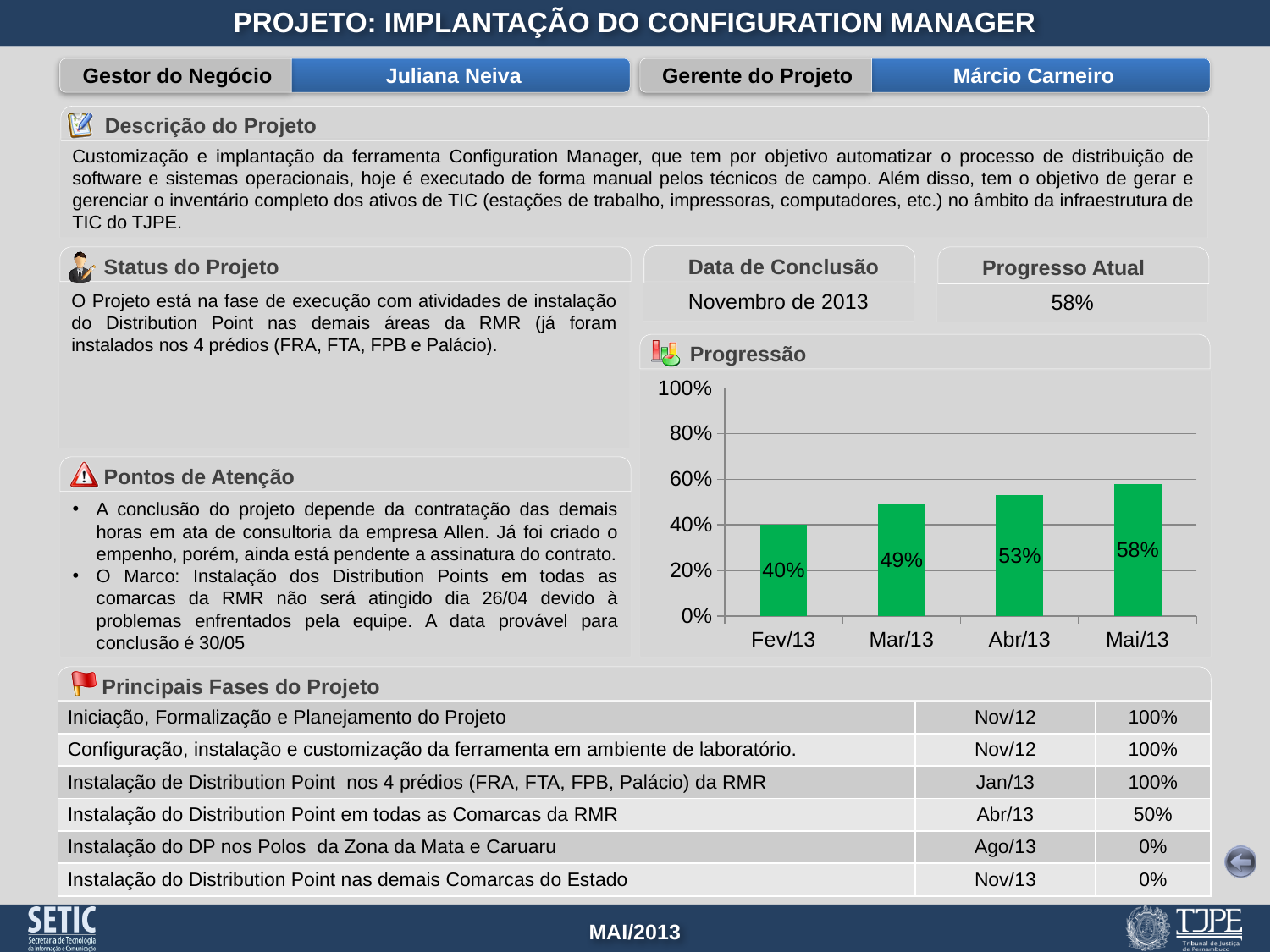
What kind of chart is the Progressão chart? bar chart Which month has the highest value in the Progressão chart? Mai/13 What is the value for Fev/13 in the Progressão chart? 40% Which month has the lowest value in the Progressão chart? Fev/13 What is the value for Mar/13 in the Progressão chart? 49% What is the value for Mai/13 in the Progressão chart? 58% Is the value for Mai/13 in the Progressão chart greater or less than 60%? less What is the difference between the values for Mai/13 and Fev/13 in the Progressão chart? 18% What is the value for Abr/13 in the Progressão chart? 53% Do the values in the Progressão chart rise or fall from Fev/13 to Mai/13? rise Which is larger in the Progressão chart, the value for Mar/13 or Abr/13? Abr/13 How many months are shown on the x axis of the Progressão chart? 4